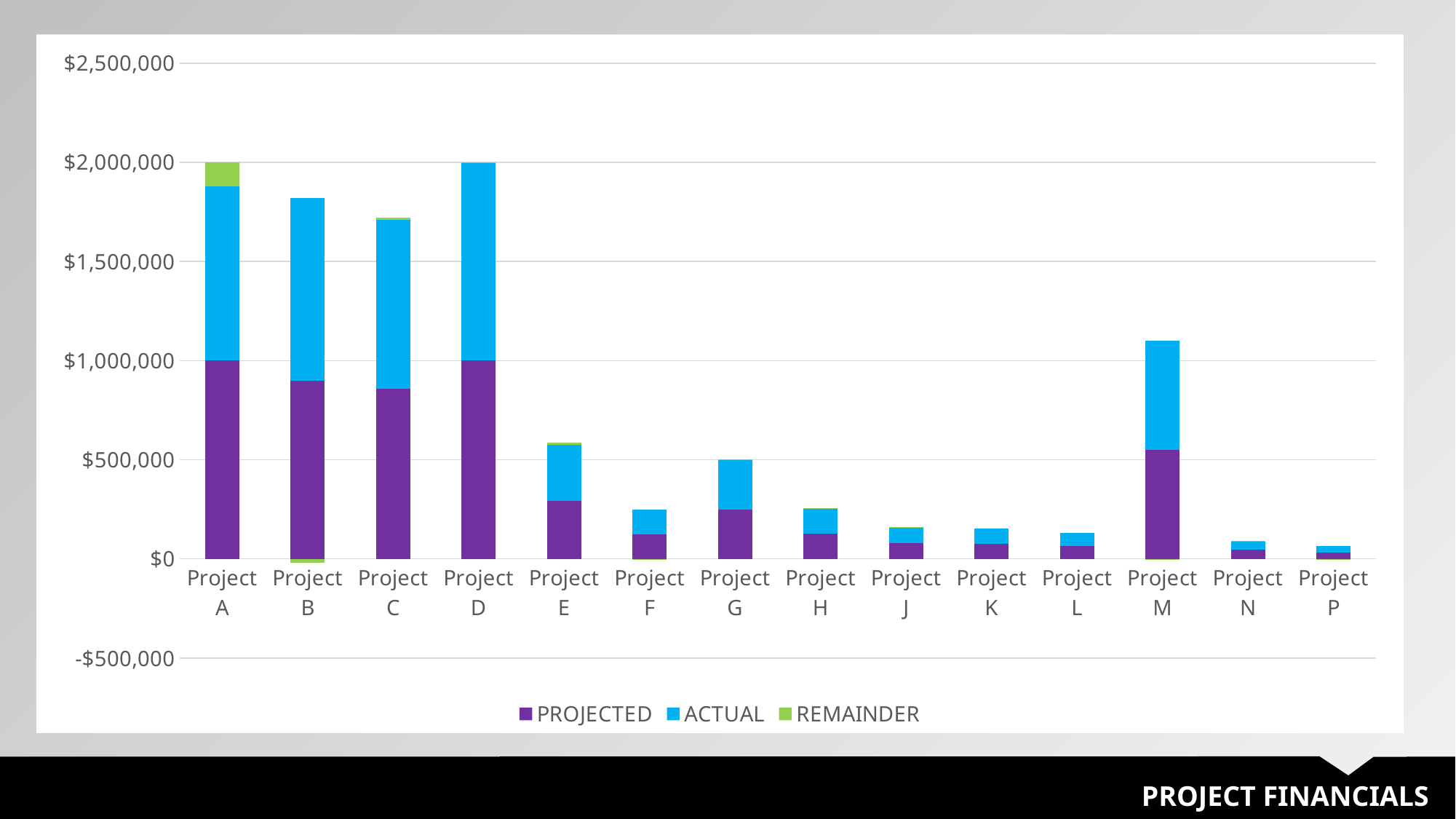
Which has the larger total bar, Project G or Project M? Project M Which has the larger total bar, Project B or Project C? Project B Is the total bar for Project F greater or less than $500,000? less Is the total bar for Project M greater or less than $1,000,000? greater How many series does the chart's legend list? 3 Is the PROJECTED value for Project C greater or less than $1,000,000? less What kind of chart is shown on the slide? Stacked bar chart What is the title shown at the bottom of the slide? PROJECT FINANCIALS How many projects are shown on the x axis of the chart? 14 Which project has the lowest total bar? Project P Which colour represents the ACTUAL series in the chart? Blue